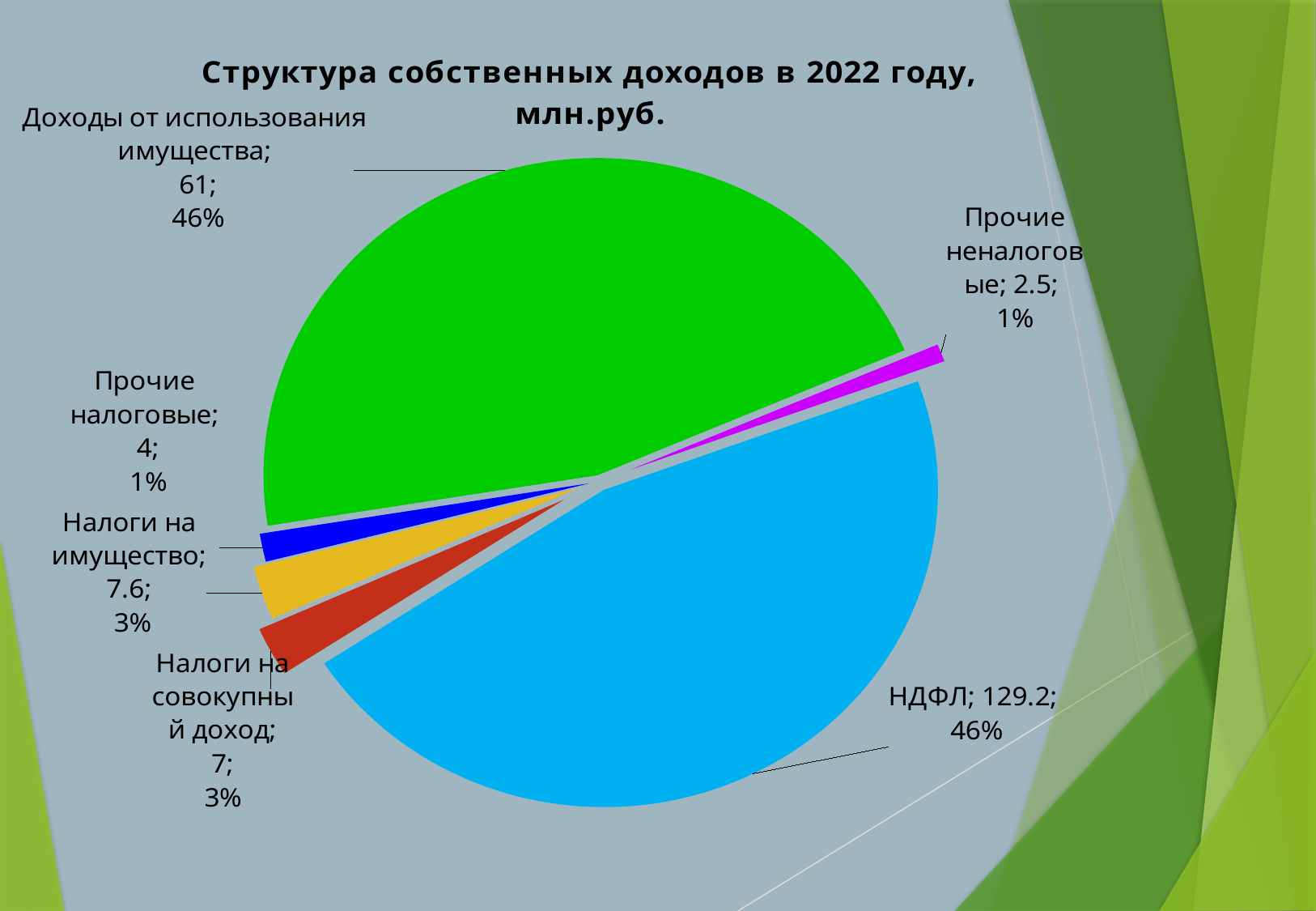
Which is larger, the value for Налоги на имущество or the value for Налоги на совокупный доход? Налоги на имущество What is the value for Прочие неналоговые? 2.5 What is the value for Доходы от использования имущества? 61 How many slices does the pie chart have? 6 What is the value for НДФЛ? 129.2 What share of the pie does Налоги на совокупный доход have? 3% What is the difference between the values for НДФЛ and Доходы от использования имущества? 68.2 What share of the pie does Прочие налоговые have? 1% What kind of chart is shown on the slide? pie chart What is the value for Налоги на имущество? 7.6 Which category has the highest value? НДФЛ Which category has the lowest value? Прочие неналоговые